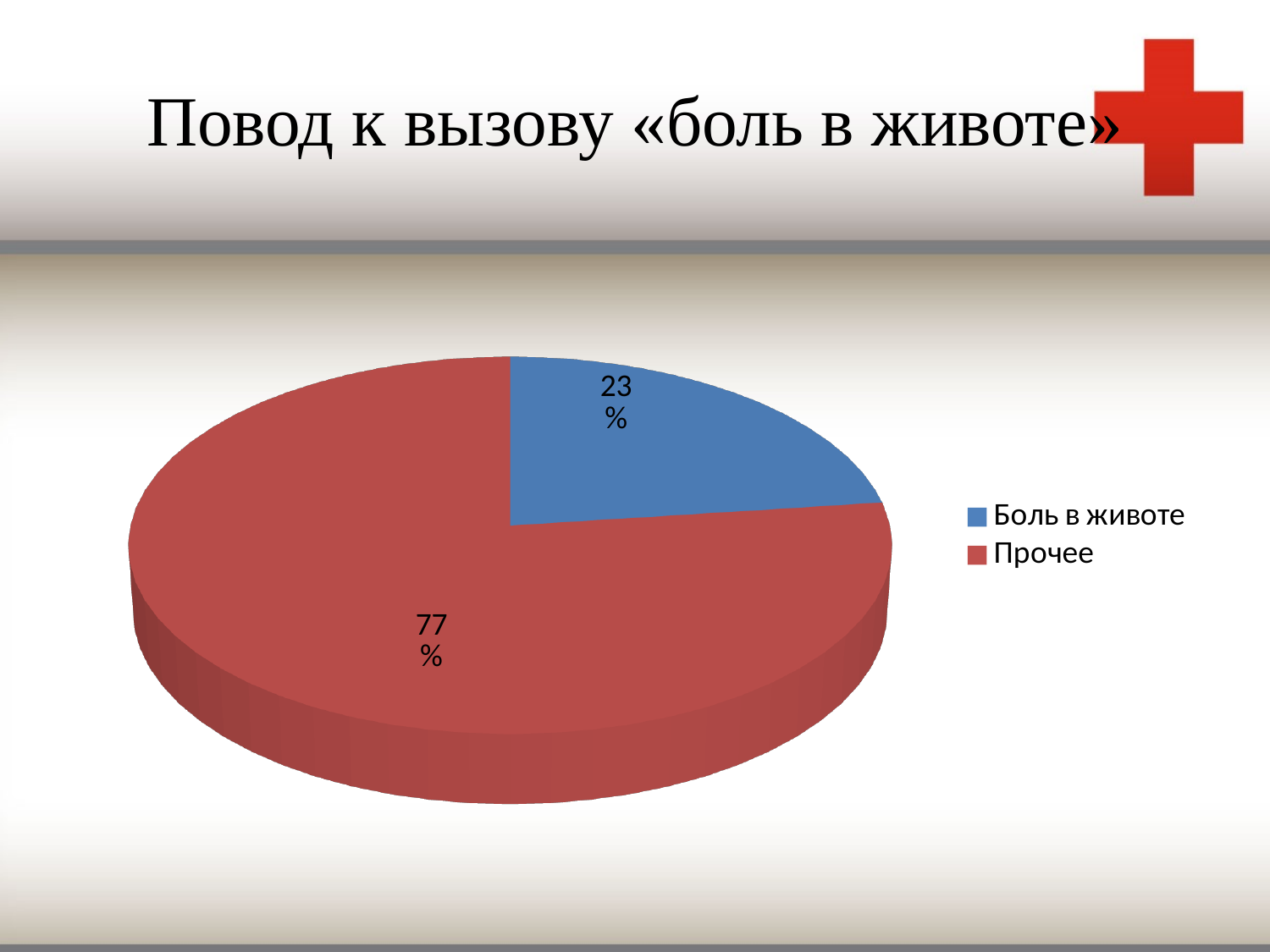
Which slice is larger, «Боль в животе» or «Прочее»? Прочее What share of the pie does the slice for «Прочее» represent? 77% Which category has the smallest slice of the pie? Боль в животе What is the difference in percentage points between the «Прочее» slice and the «Боль в животе» slice? 54 Which category has the largest slice of the pie? Прочее What is the title of the slide? Повод к вызову «боль в животе» How many entries does the legend list? 2 What kind of chart is shown on the slide? Pie chart What colour is the slice for «Боль в животе»? Blue How many slices does the pie chart have? 2 What share of the pie does the slice for «Боль в животе» represent? 23%